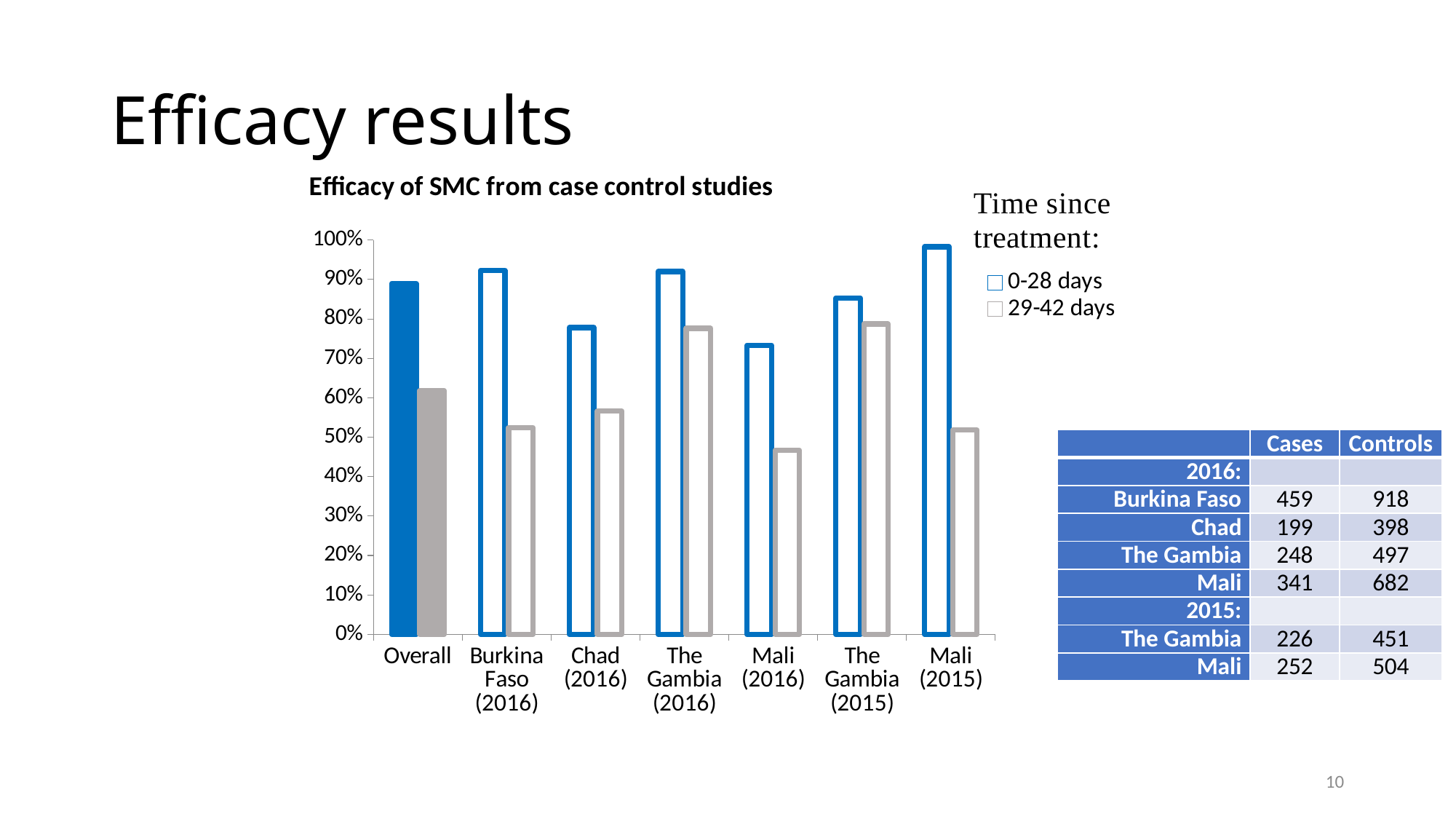
Is the 29-42 days value for Mali (2016) greater or less than 50%? less Which category has the lowest value for the 0-28 days series? Mali (2016) What kind of chart is shown on the slide? bar chart For Burkina Faso (2016), which series has the larger value, 0-28 days or 29-42 days? 0-28 days Is the 0-28 days value for Overall greater or less than 80%? greater Is the 0-28 days value for Chad (2016) greater or less than 90%? less What is the title of the chart? Efficacy of SMC from case control studies Which is larger: the 29-42 days value for Overall or the 29-42 days value for Burkina Faso (2016)? Overall How many categories are shown along the x axis of the chart? 7 How many series does the chart legend list? 2 Which category has the highest value for the 0-28 days series? Mali (2015)